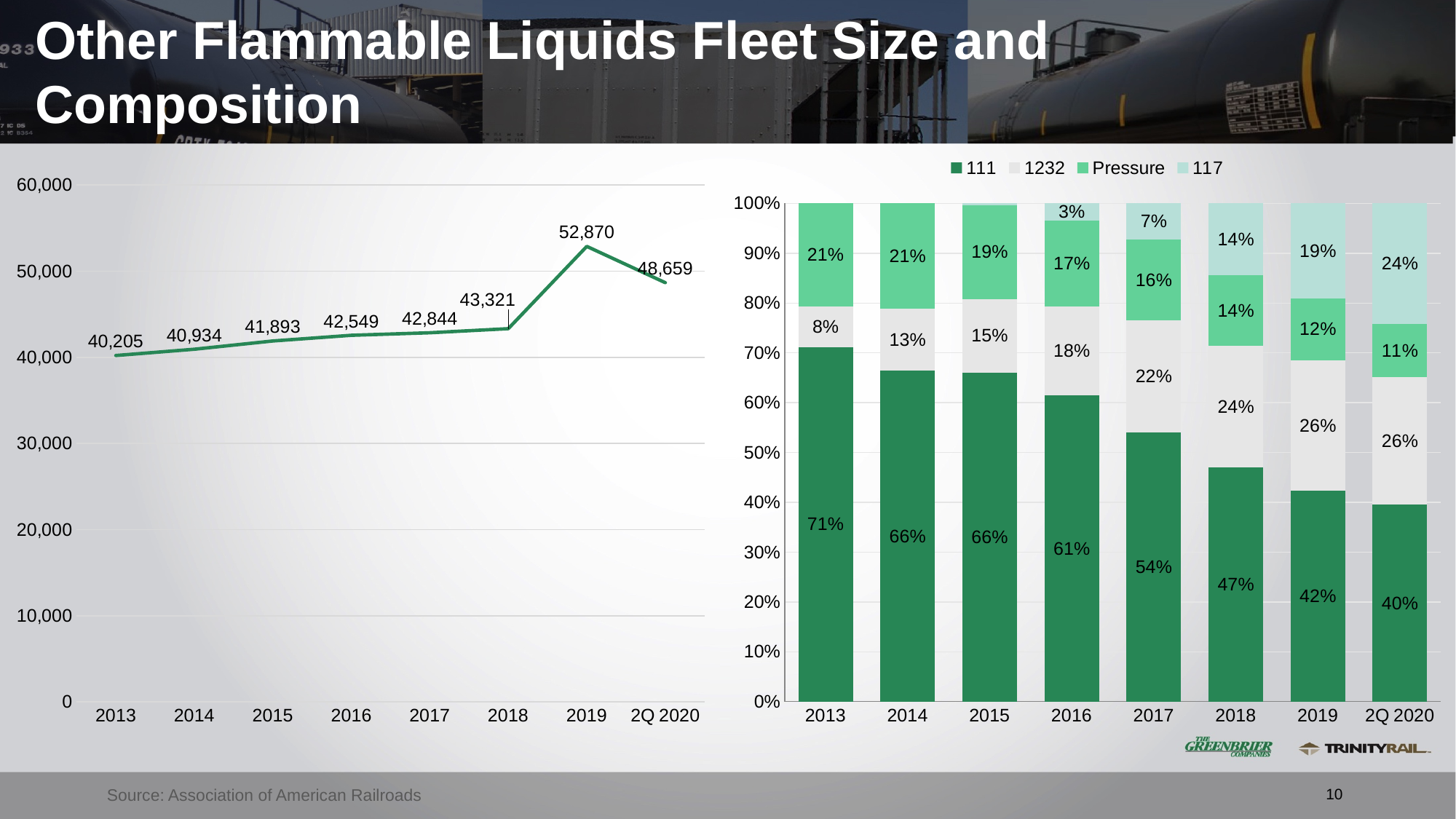
In the stacked bar chart on the right, what is the 117 share for 2018? 14% In the stacked bar chart on the right, how many series does the legend list? 4 In the line chart on the left, which year has the highest value? 2019 In the line chart on the left, what is the value for 2013? 40,205 What kind of chart is the chart on the left? Line chart In the stacked bar chart on the right, which is larger in 2017: the 1232 share or the Pressure share? 1232 In the line chart on the left, what is the difference between the 2019 value and the 2Q 2020 value? 4,211 In the line chart on the left, which year has the lowest value? 2013 In the stacked bar chart on the right, does the 111 share rise or fall from 2013 to 2Q 2020? Fall In the line chart on the left, what is the value for 2019? 52,870 In the line chart on the left, how many data points are plotted? 8 In the stacked bar chart on the right, what is the 111 share for 2Q 2020? 40%